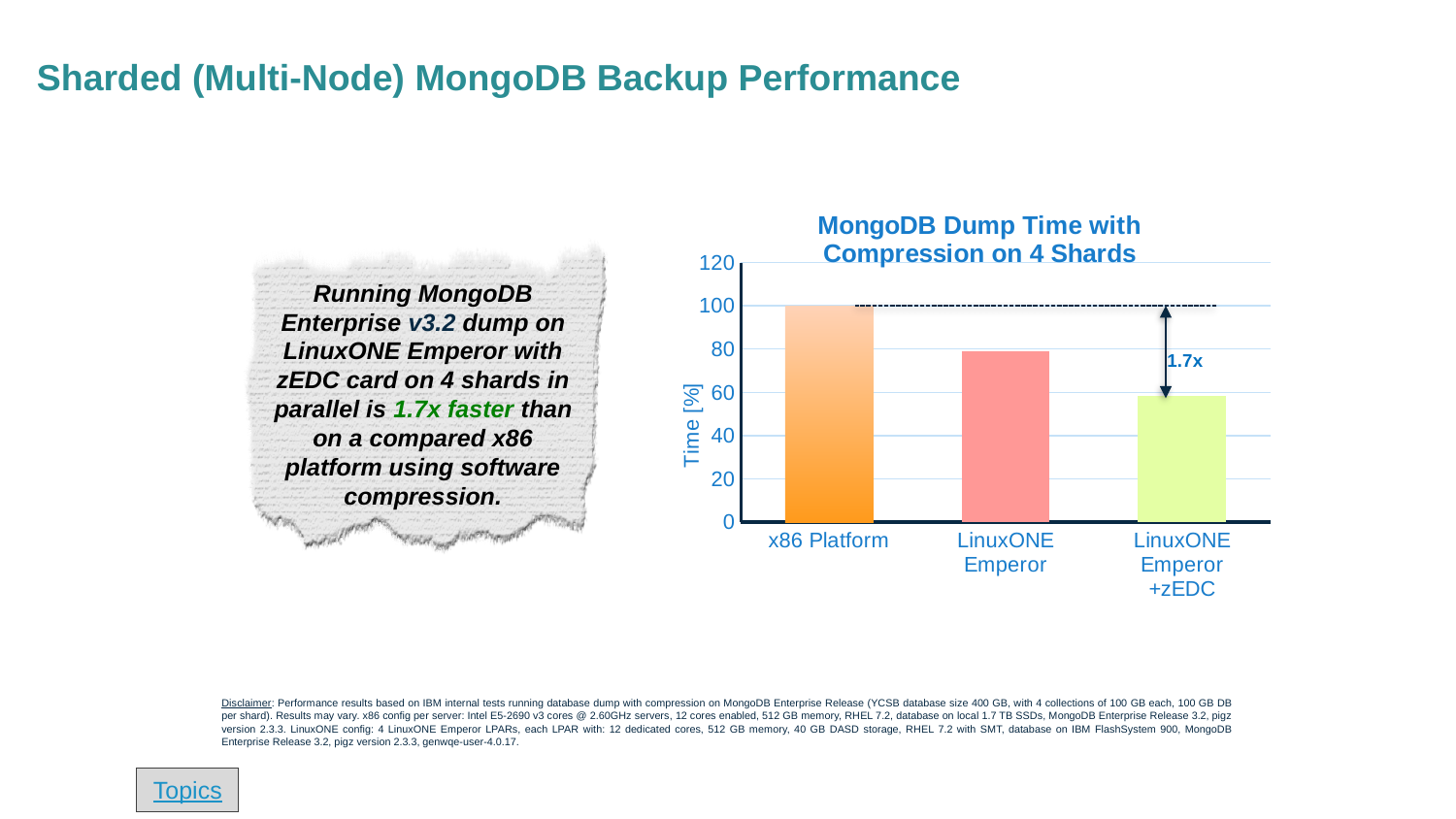
Is the value for LinuxONE Emperor +zEDC greater or less than 80? less Is the value for LinuxONE Emperor greater or less than 100? less Which category has the highest value in the chart? x86 Platform How many bars (categories) are plotted in the chart? 3 What is the y-axis label of the chart? Time [%] What is the value for x86 Platform in the chart? 100 Is the value for LinuxONE Emperor greater or less than 60? greater Which is larger, the value for LinuxONE Emperor or the value for LinuxONE Emperor +zEDC? LinuxONE Emperor Do the values rise or fall from left to right across the categories? fall Which category has the lowest value in the chart? LinuxONE Emperor +zEDC What is the title of the chart? MongoDB Dump Time with Compression on 4 Shards What type of chart is shown on the slide? bar chart